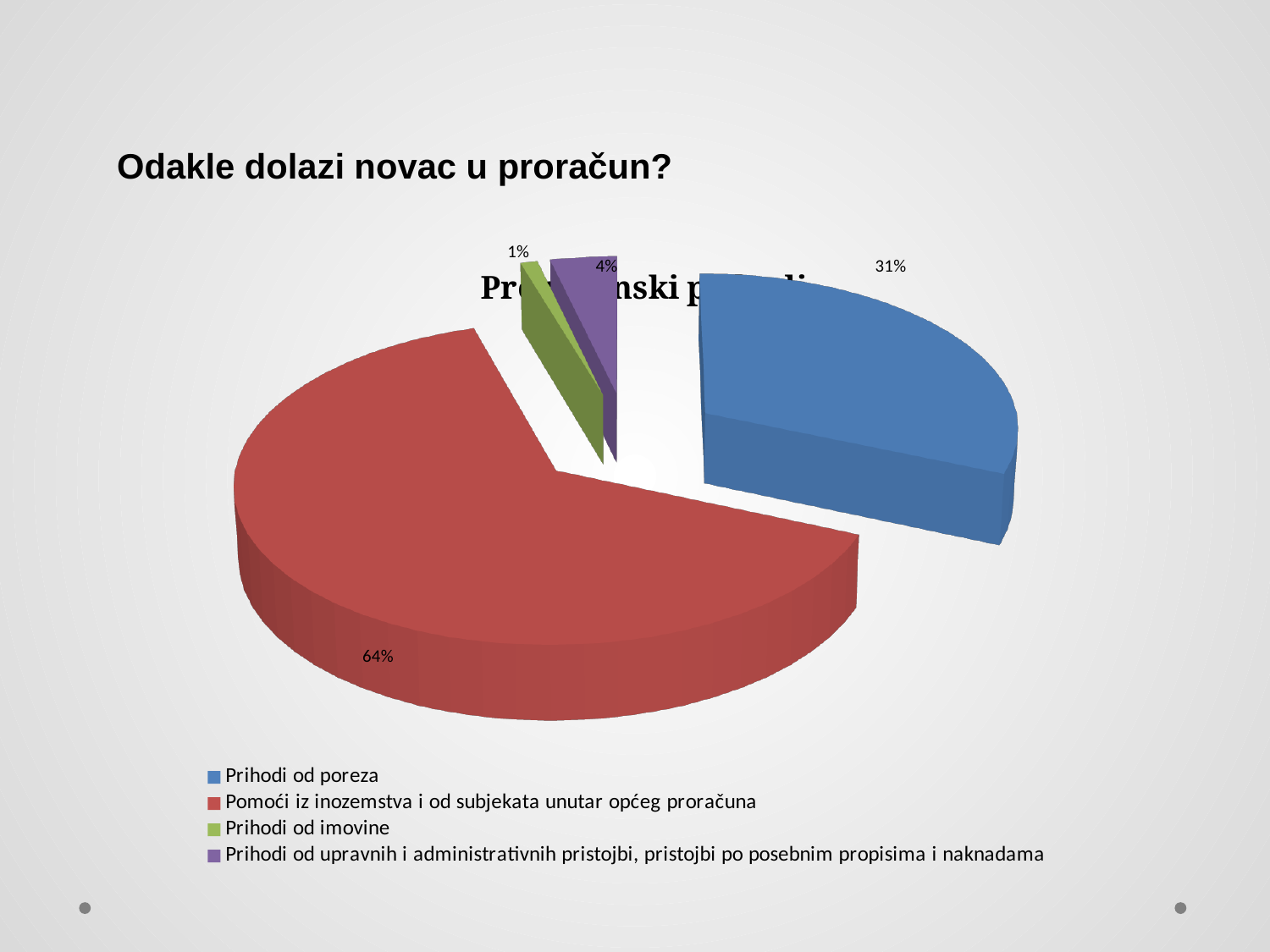
What share of the pie does "Pomoći iz inozemstva i od subjekata unutar općeg proračuna" have? 64% What is the title of the slide? Odakle dolazi novac u proračun? Which category has the smallest slice of the pie? Prihodi od imovine How many categories does the pie chart have? 4 Which category has the largest slice of the pie? Pomoći iz inozemstva i od subjekata unutar općeg proračuna Which is larger: the share for "Prihodi od poreza" or the share for "Prihodi od upravnih i administrativnih pristojbi, pristojbi po posebnim propisima i naknadama"? Prihodi od poreza What share of the pie does "Prihodi od upravnih i administrativnih pristojbi, pristojbi po posebnim propisima i naknadama" have? 4% What kind of chart is shown on the slide? pie chart What share of the pie does "Prihodi od imovine" have? 1% What colour is the slice for "Prihodi od poreza"? blue What is the difference in percentage points between "Pomoći iz inozemstva i od subjekata unutar općeg proračuna" and "Prihodi od poreza"? 33